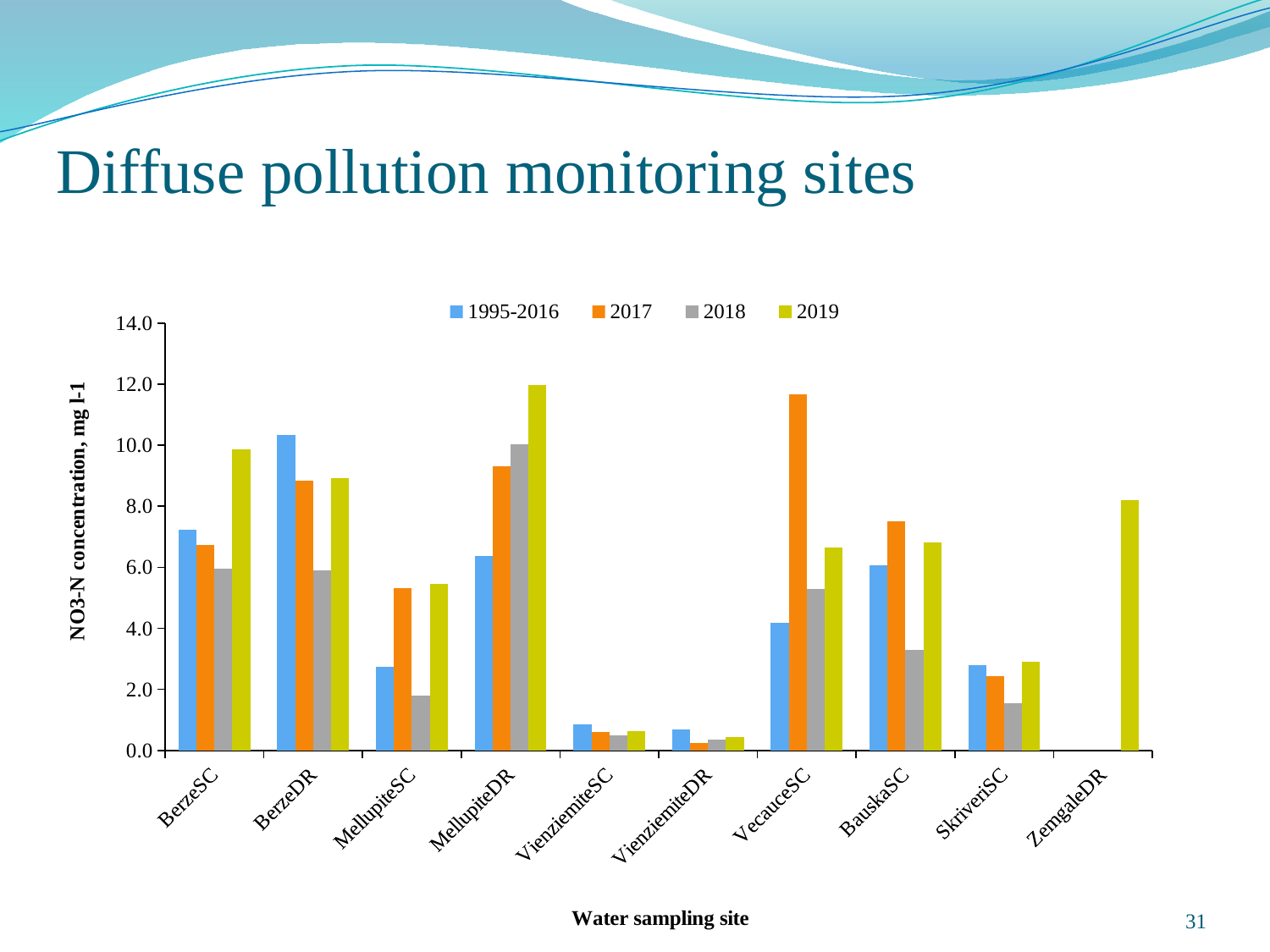
What kind of chart is shown on the slide? bar chart For MellupiteSC, which is larger: the 2017 value or the 2018 value? 2017 Which water sampling site has the lowest 2017 value? VienziemiteDR Which water sampling site has the highest 2017 value? VecauceSC Is the 2018 value for BauskaSC greater or less than 4.0? less For BerzeSC, which is larger: the 1995-2016 value or the 2019 value? 2019 Which water sampling site has the highest 2019 value? MellupiteDR Is the 2019 value for MellupiteDR greater or less than 10.0? greater Is the 2019 value for ZemgaleDR greater or less than 6.0? greater How many water sampling sites are shown on the x axis? 10 What is the label of the y axis? NO3-N concentration, mg l-1 How many series does the legend list? 4